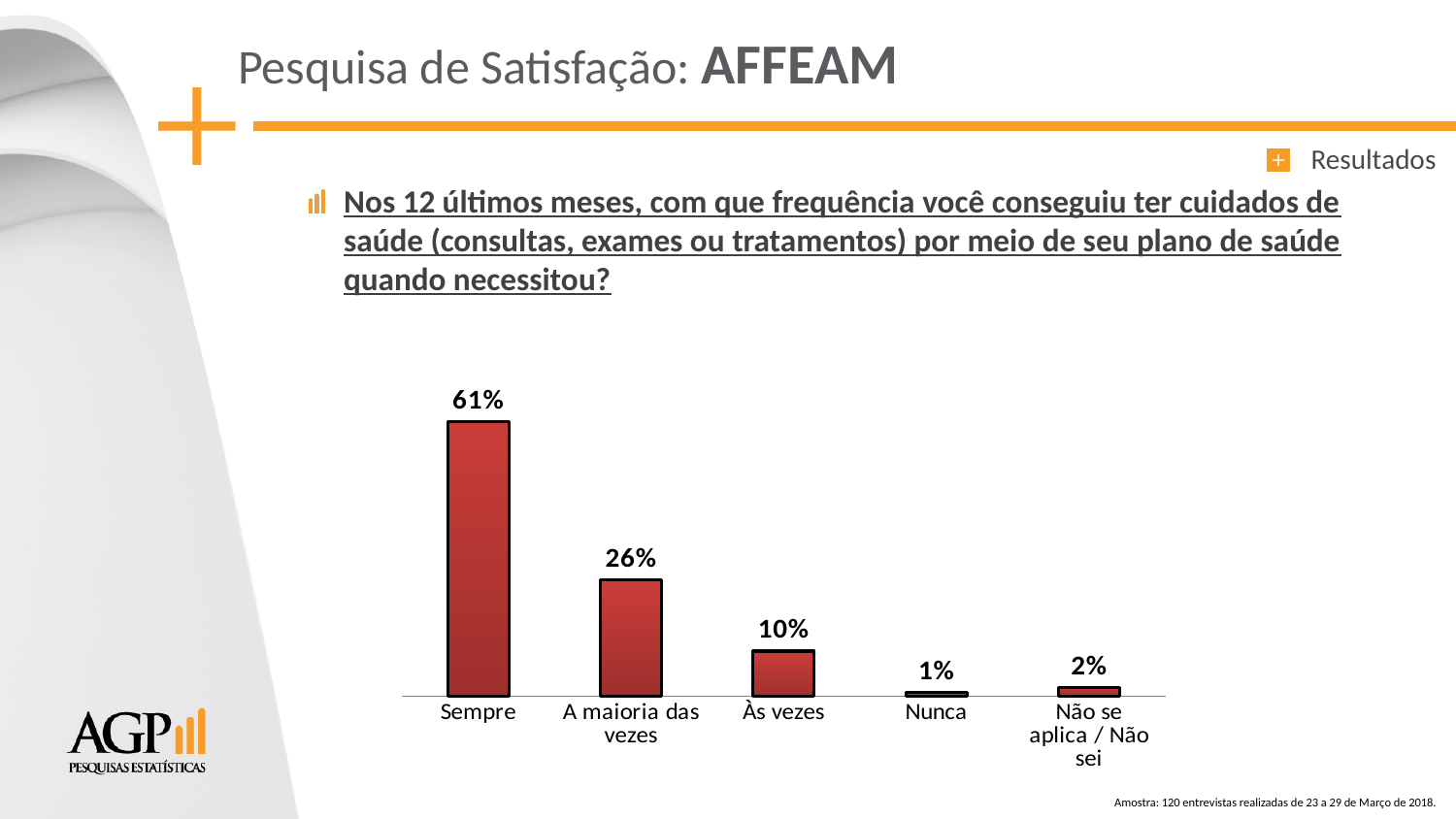
How many categories are shown in the chart? 5 What is the difference between the values for "Sempre" and "A maioria das vezes"? 35% What kind of chart is shown on the slide? Bar chart What is the sample size stated at the bottom of the slide? 120 entrevistas Which category has the lowest value? Nunca What is the value for "Sempre"? 61% What is the value for "A maioria das vezes"? 26% What is the value for "Nunca"? 1% Which category has the highest value? Sempre What is the value for "Não se aplica / Não sei"? 2% What is the value for "Às vezes"? 10% Which is larger, the value for "Às vezes" or the value for "Não se aplica / Não sei"? Às vezes